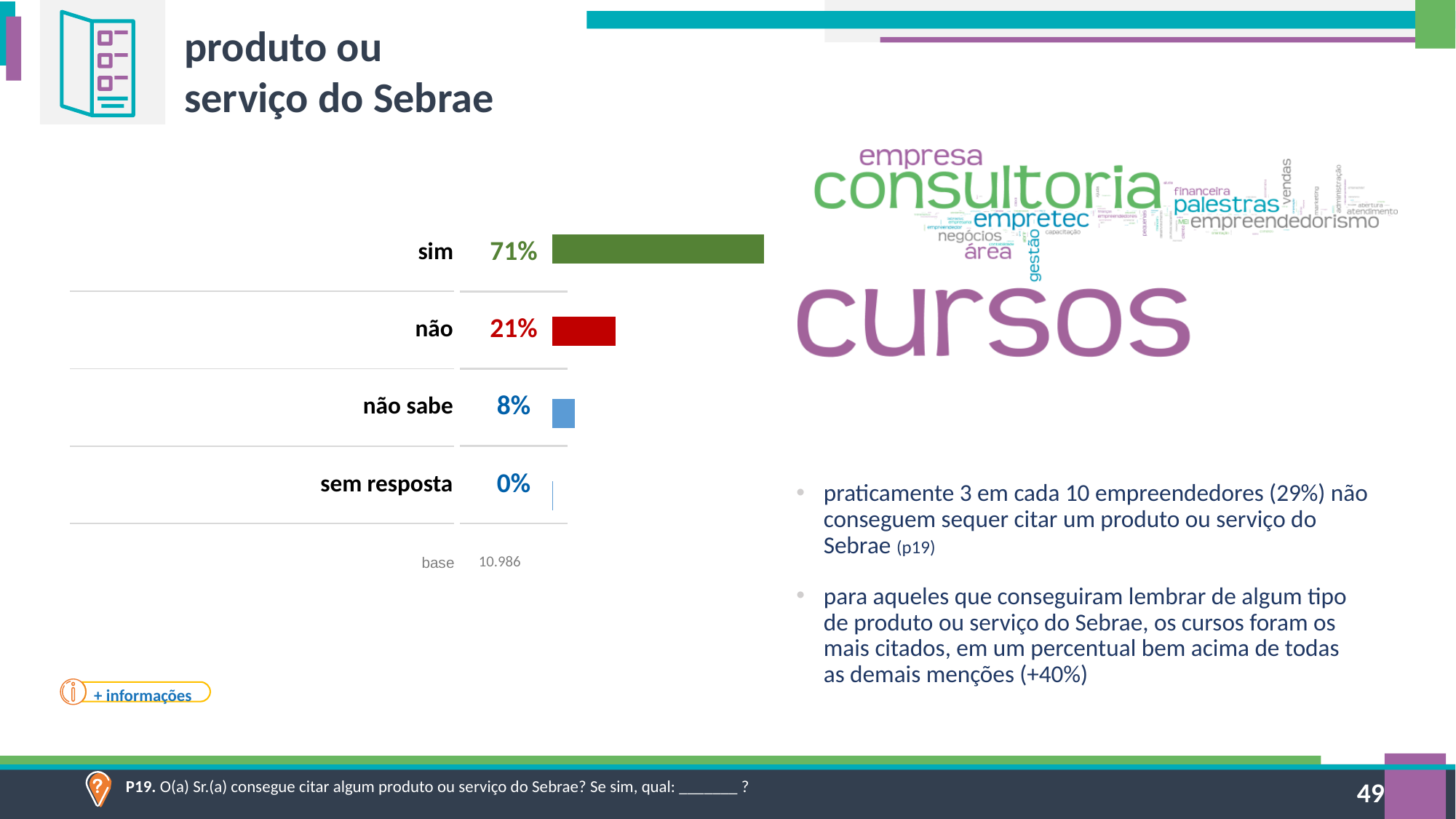
What is the base (number of respondents) shown below the chart? 10.986 What kind of chart is shown on the left of the slide? bar chart What is the difference between the values for "sim" and "não"? 50% What is the value for "sem resposta"? 0% What is the value for "não sabe"? 8% Which is larger, the value for "não" or the value for "não sabe"? não Which category has the highest value? sim What is the value for "não"? 21% How many categories are shown in the bar chart? 4 What colour is the bar for "não"? red What is the value for "sim"? 71% Which category has the lowest value? sem resposta